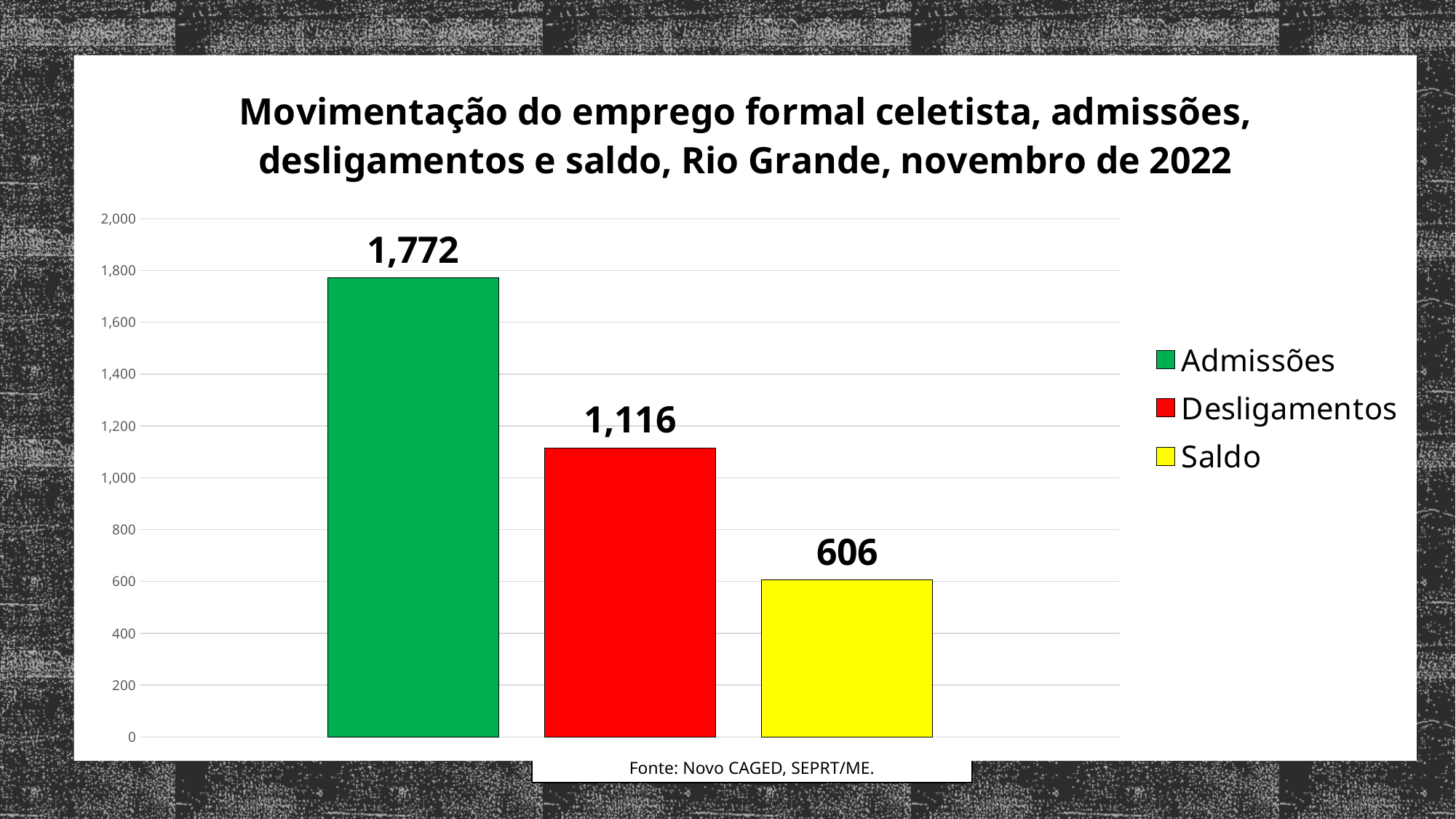
How many bars are plotted in the chart? 3 What is the value for Admissões? 1,772 How many series does the legend list? 3 Is the value for Desligamentos greater or less than 1,000? greater What colour is the bar for Saldo? yellow Which is larger, Desligamentos or Saldo? Desligamentos Which series has the lowest value? Saldo What is the difference between Admissões and Desligamentos? 656 What is the value for Desligamentos? 1,116 What is the value for Saldo? 606 What kind of chart is shown on the slide? bar chart Which series has the highest value? Admissões